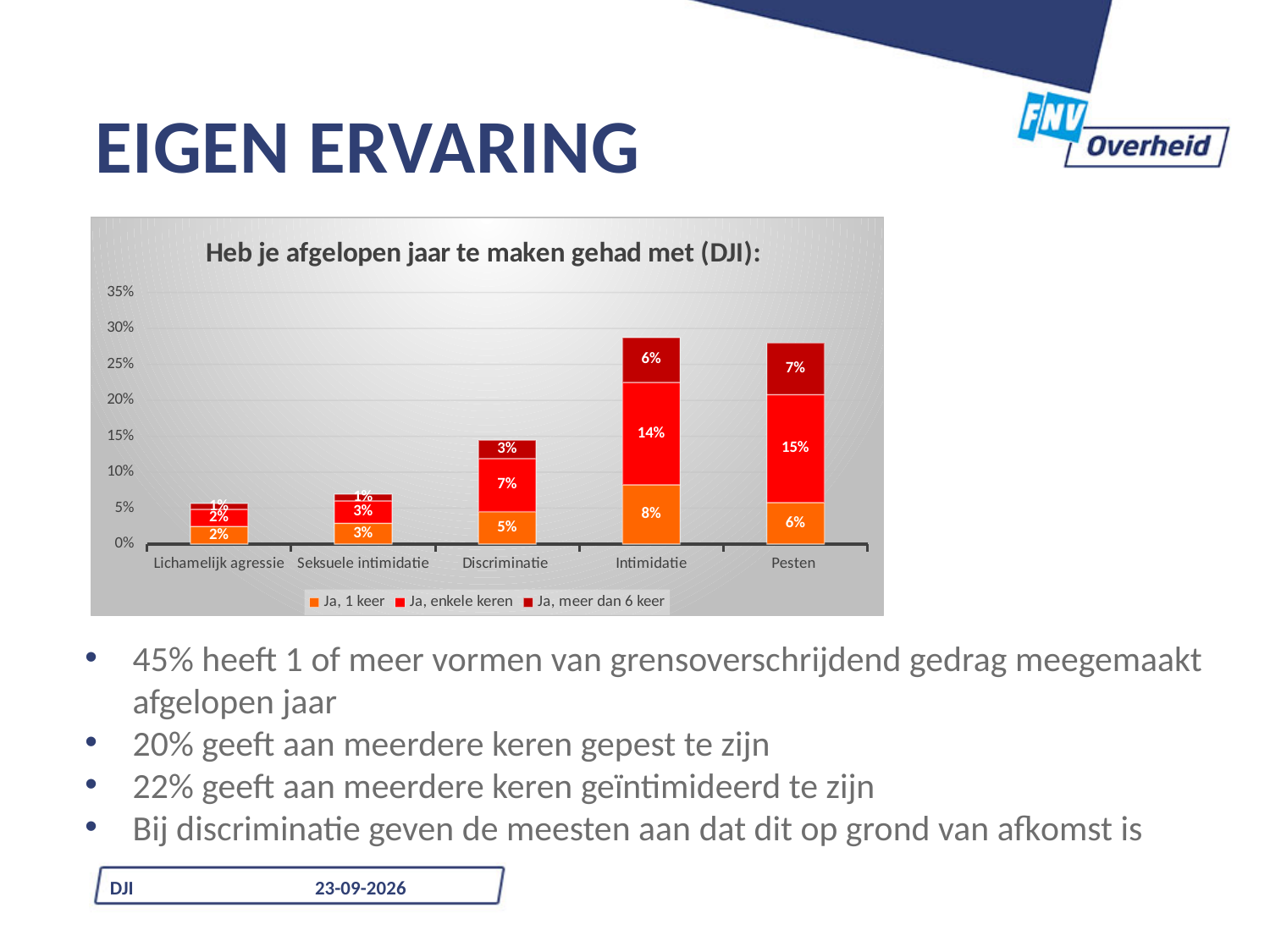
What is the value for 'Ja, meer dan 6 keer' for Discriminatie? 3% What is the total of the stacked bar for Discriminatie? 15% What kind of chart is shown on the slide? Stacked bar chart What is the value for 'Ja, 1 keer' for Intimidatie? 8% What is the value for 'Ja, enkele keren' for Pesten? 15% Which category has the lowest total stacked bar? Lichamelijk agressie Which is larger for 'Ja, 1 keer': Intimidatie or Pesten? Intimidatie How many series does the legend list? 3 How many categories are shown on the x axis? 5 What is the difference between the 'Ja, enkele keren' values for Pesten and Intimidatie? 1 percentage point What is the total of the stacked bar for Intimidatie? 28% Which category has the highest value for 'Ja, enkele keren'? Pesten